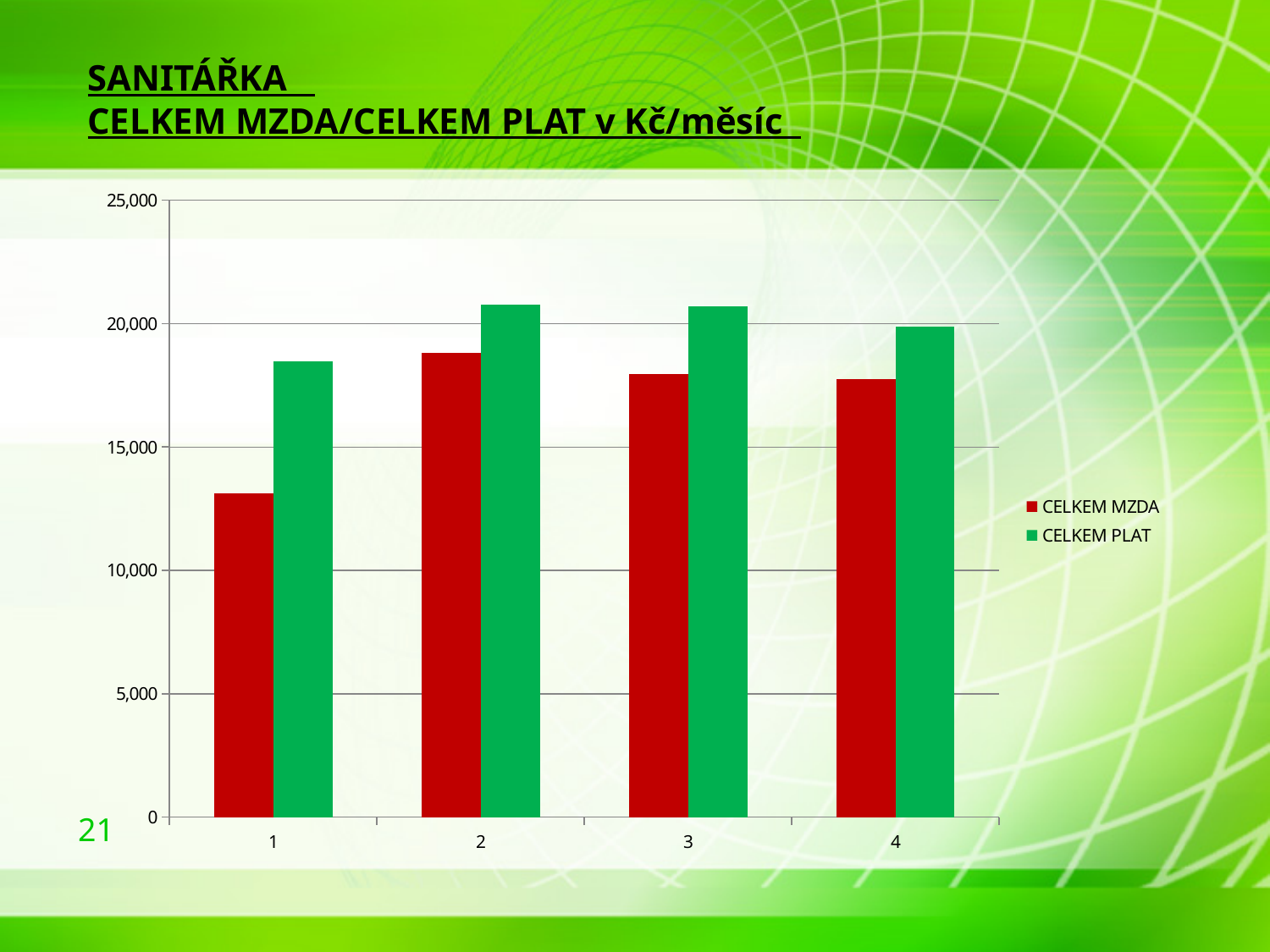
What is the title of the chart on the slide? SANITÁŘKA CELKEM MZDA/CELKEM PLAT v Kč/měsíc What are the two series named in the legend? CELKEM MZDA and CELKEM PLAT How many categories are shown on the x axis? 4 Is the CELKEM MZDA value for category 1 greater or less than 15,000? less What kind of chart is shown on the slide? bar chart Does the CELKEM MZDA value rise or fall from category 2 to category 4? fall Is the CELKEM PLAT value for category 2 greater or less than 20,000? greater Which category has the lowest value for CELKEM MZDA? 1 In category 1, which is larger: CELKEM MZDA or CELKEM PLAT? CELKEM PLAT How many series does the legend list? 2 Which category has the highest value for CELKEM MZDA? 2 Which category has the lowest value for CELKEM PLAT? 1